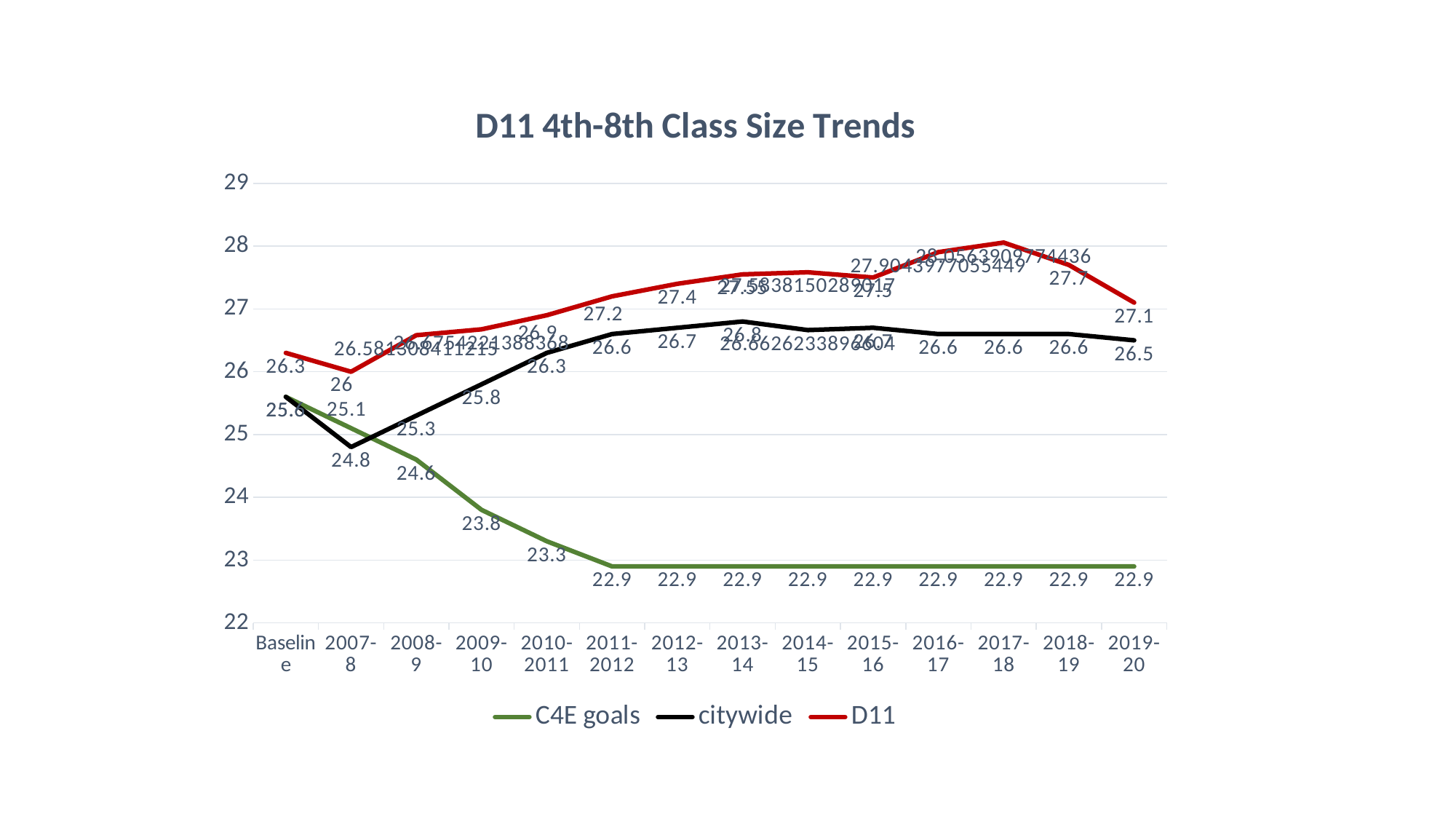
How many series does the legend list? 3 What is the D11 value for 2019-20? 27.1 In which year does the citywide series reach its lowest value? 2007-8 How many categories are shown along the x axis? 14 What is the difference between the D11 and citywide values in 2019-20? 0.6 What is the C4E goals value for 2009-10? 23.8 What kind of chart is shown on the slide? line chart In which year does the D11 series reach its highest value? 2017-18 Do the C4E goals values rise or fall from Baseline to 2011-2012? fall Is the D11 value for 2007-8 greater or less than 27? less In 2012-13, which is larger, the D11 value or the citywide value? D11 What is the citywide value for 2007-8? 24.8